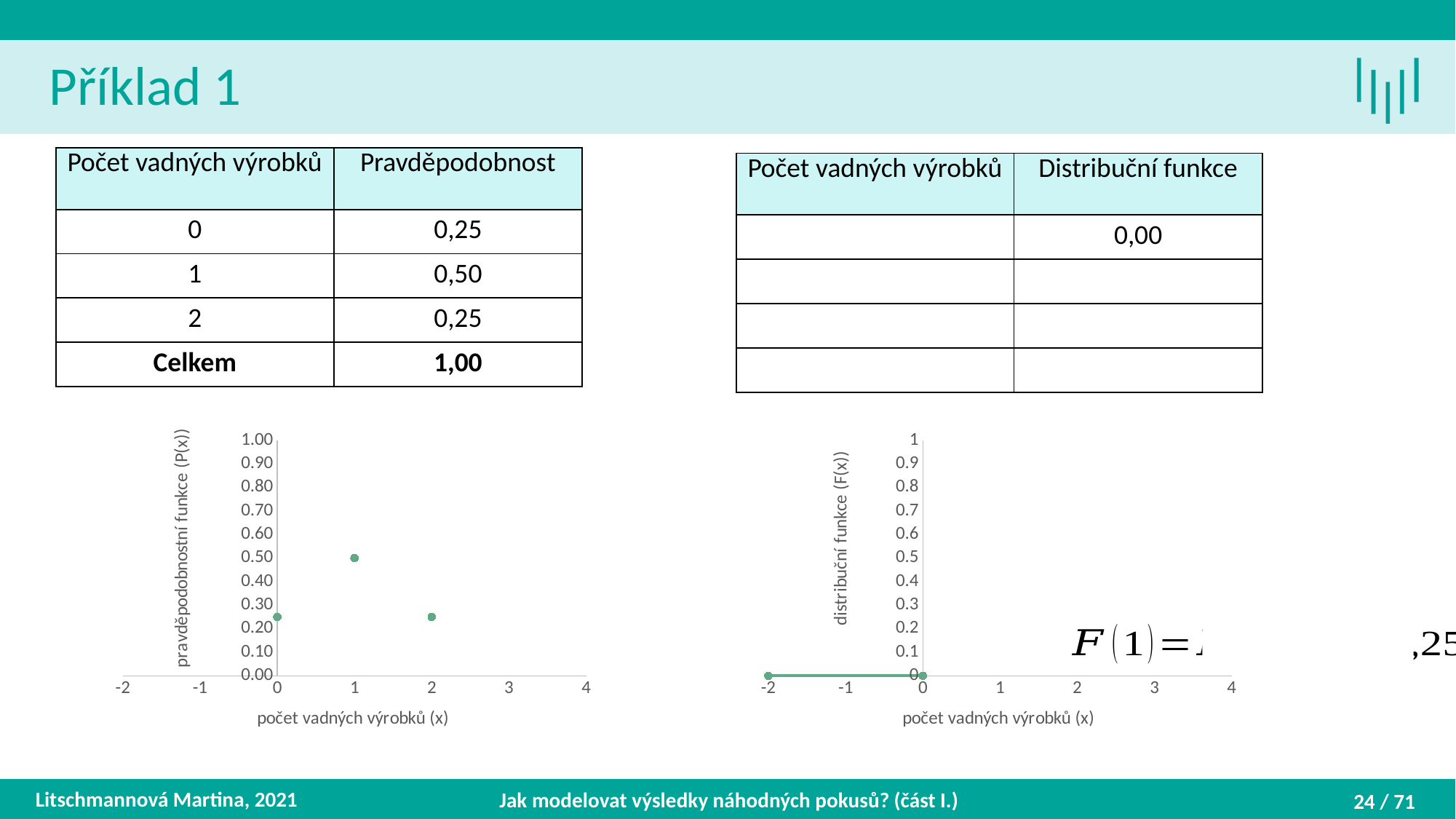
On the left chart (pravděpodobnostní funkce), do the values rise or fall from x = 1 to x = 2? fall On the right chart (distribuční funkce), what is the value of F(x) at x = -2? 0 What is the y-axis title of the right chart (distribuční funkce)? distribuční funkce (F(x)) What is the x-axis title of the left chart (pravděpodobnostní funkce)? počet vadných výrobků (x) On the left chart (pravděpodobnostní funkce), is the value at x = 2 greater or less than 0.30? less On the left chart (pravděpodobnostní funkce), which point is higher, the one at x = 1 or the one at x = 2? x = 1 On the left chart (pravděpodobnostní funkce), at which value of x is the plotted point highest? 1 How many data points are plotted on the left chart (pravděpodobnostní funkce)? 3 On the left chart (pravděpodobnostní funkce), what is the value of P(x) at x = 1? 0.50 On the left chart (pravděpodobnostní funkce), is the value at x = 0 greater or less than 0.20? greater What kind of chart is the left chart (pravděpodobnostní funkce)? scatter chart How many data points are plotted on the right chart (distribuční funkce)? 2